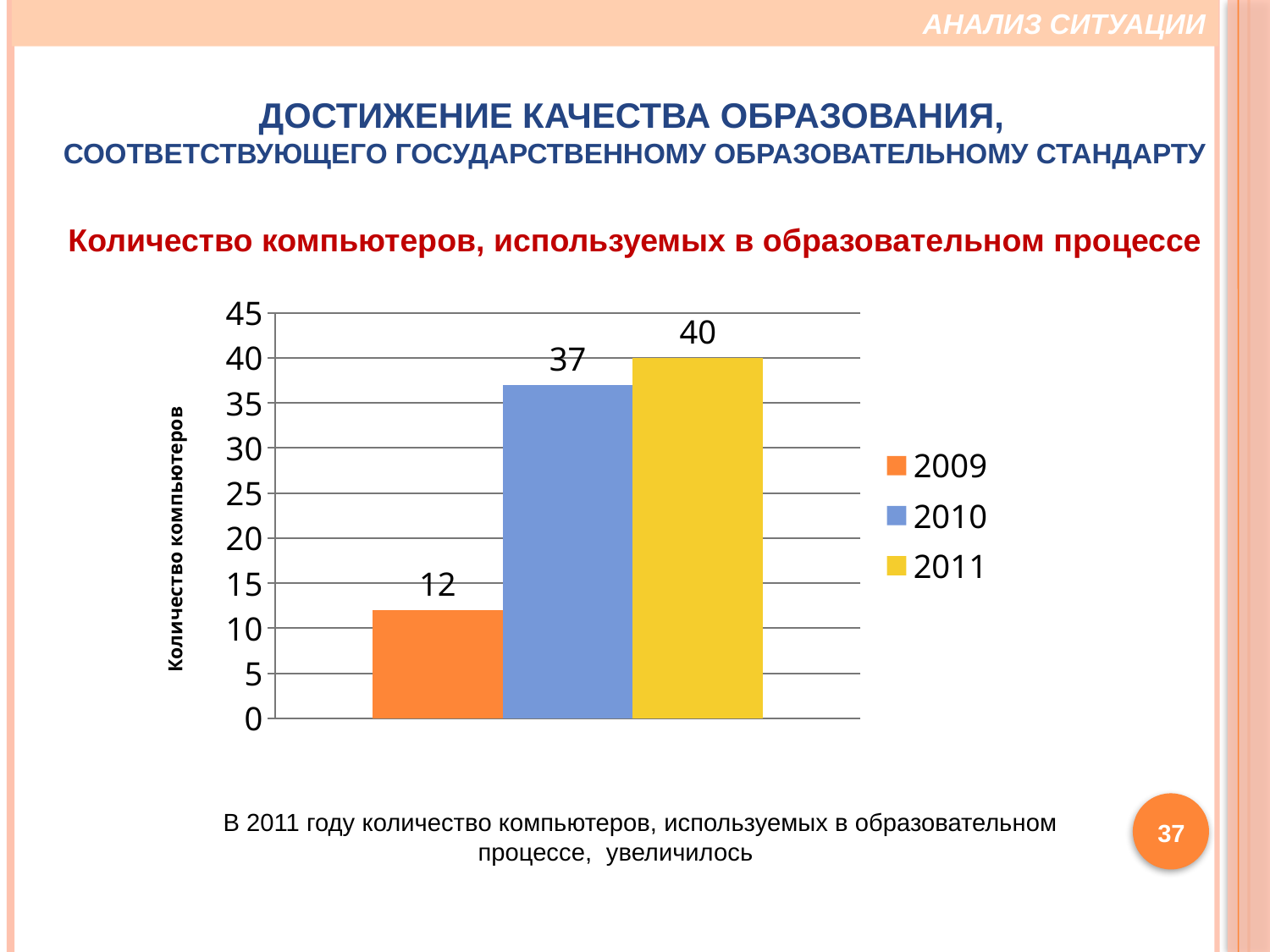
What kind of chart is shown on the slide? bar chart What is the number of computers for 2010? 37 What is the difference between the values for 2011 and 2009? 28 What is the difference between the values for 2010 and 2009? 25 What is the number of computers for 2009? 12 How many series does the legend list? 3 What is the label of the vertical axis? Количество компьютеров What is the number of computers for 2011? 40 Which year has the lowest number of computers? 2009 Is the value for 2009 greater or less than 15? less Which year has the highest number of computers? 2011 Which is larger, the value for 2010 or the value for 2011? 2011